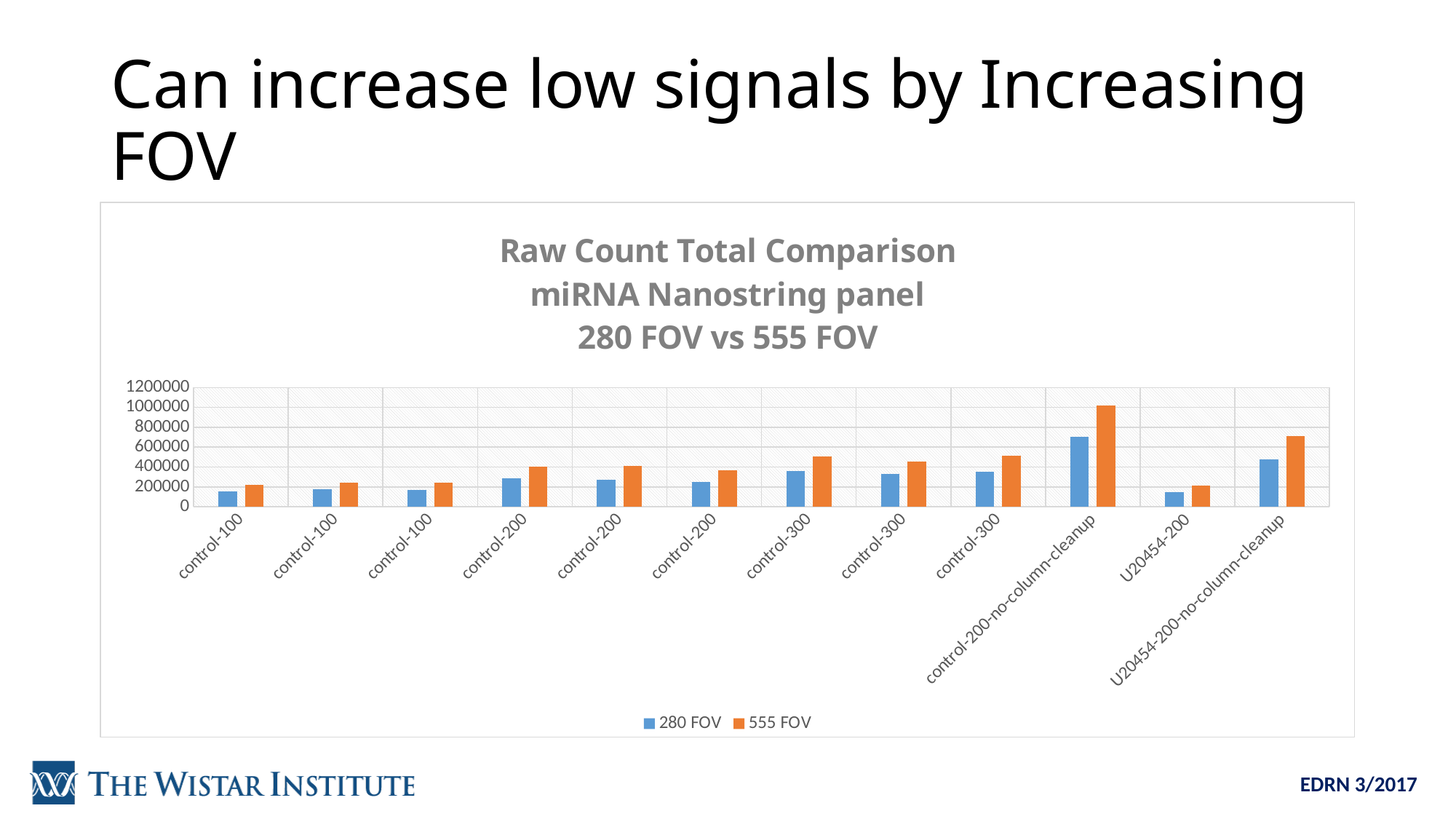
Is the 555 FOV value for U20454-200-no-column-cleanup greater or less than 600000? greater For control-200-no-column-cleanup, which series has the larger value, 280 FOV or 555 FOV? 555 FOV Which series is shown in orange? 555 FOV Is the 555 FOV value for control-200-no-column-cleanup greater or less than 800000? greater What kind of chart is shown on the slide? bar chart How many series does the legend list? 2 What is the first line of the chart title? Raw Count Total Comparison Is the 280 FOV value for U20454-200 greater or less than 200000? less Which category has the highest 555 FOV value? control-200-no-column-cleanup How many categories are shown along the x axis? 12 Which category has the highest 280 FOV value? control-200-no-column-cleanup